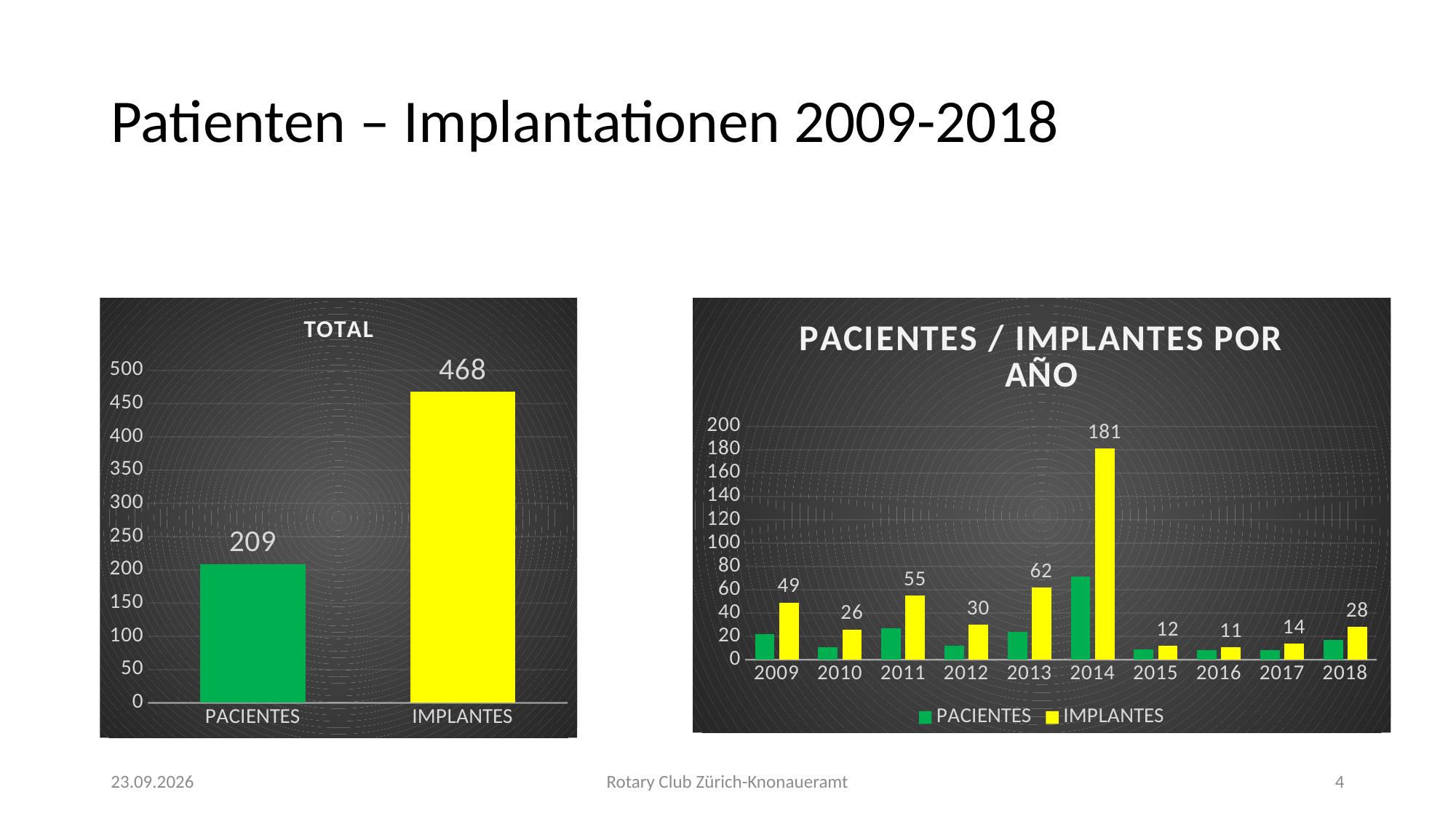
In the PACIENTES / IMPLANTES POR AÑO chart, is the PACIENTES value for 2014 greater or less than 60? greater In the TOTAL chart, what is the difference between IMPLANTES and PACIENTES? 259 In the PACIENTES / IMPLANTES POR AÑO chart, which year has the highest IMPLANTES value? 2014 In the PACIENTES / IMPLANTES POR AÑO chart, what is the difference between the IMPLANTES values for 2013 and 2012? 32 How many years are shown on the x axis of the PACIENTES / IMPLANTES POR AÑO chart? 10 In the TOTAL chart, what is the value for IMPLANTES? 468 In the TOTAL chart, which category is higher, PACIENTES or IMPLANTES? IMPLANTES In the PACIENTES / IMPLANTES POR AÑO chart, what is the IMPLANTES value for 2014? 181 In the PACIENTES / IMPLANTES POR AÑO chart, which year has the lowest IMPLANTES value? 2016 In the PACIENTES / IMPLANTES POR AÑO chart, what is the IMPLANTES value for 2011? 55 How many series does the legend of the PACIENTES / IMPLANTES POR AÑO chart list? 2 In the TOTAL chart, what is the value for PACIENTES? 209